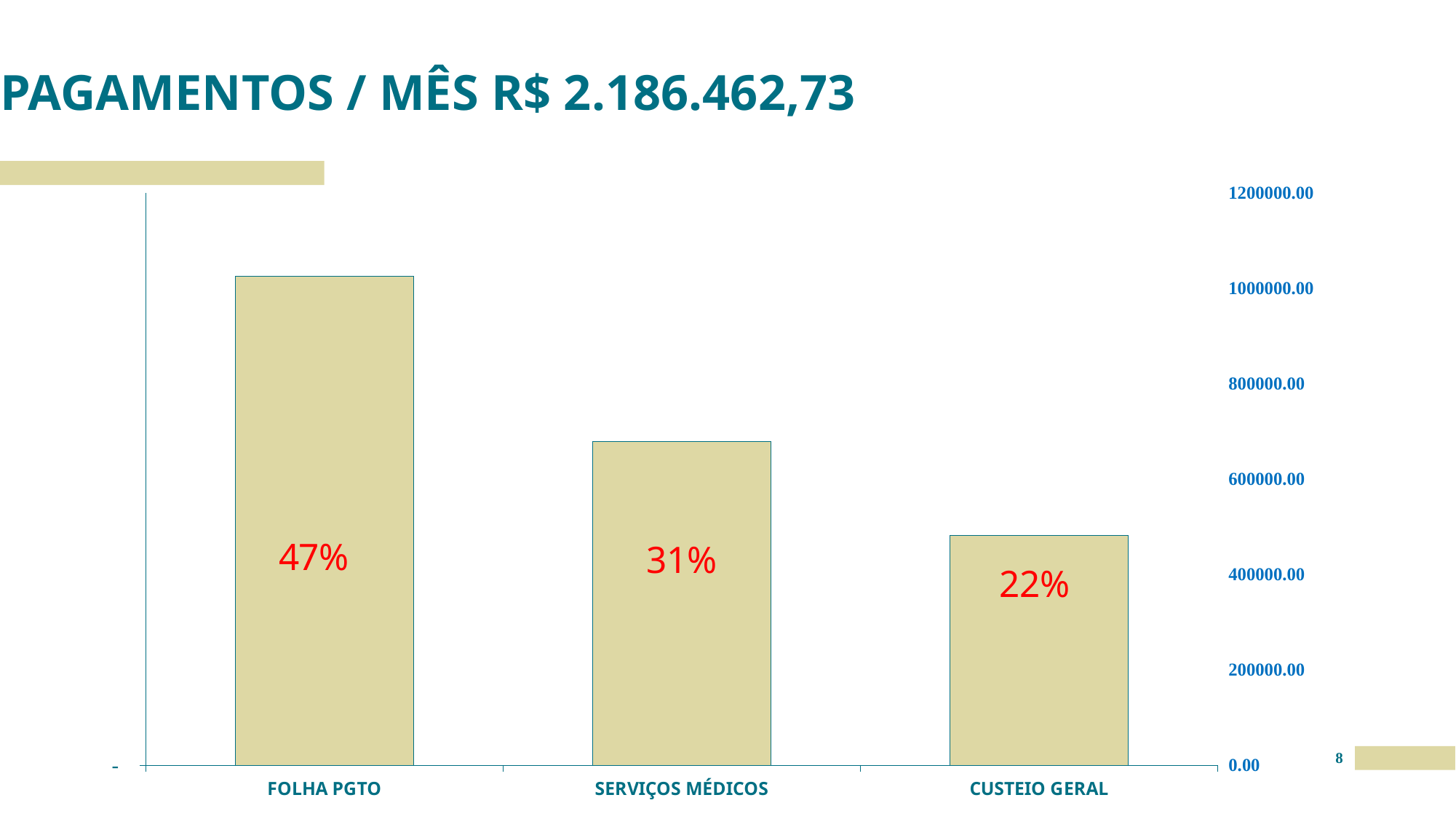
What percentage label is shown on the FOLHA PGTO bar? 47% Which bar is taller, SERVIÇOS MÉDICOS or CUSTEIO GERAL? SERVIÇOS MÉDICOS Which category has the lowest bar? CUSTEIO GERAL What is the title of the slide? PAGAMENTOS / MÊS R$ 2.186.462,73 Which category has the highest bar? FOLHA PGTO What percentage label is shown on the SERVIÇOS MÉDICOS bar? 31% Is the value for FOLHA PGTO greater or less than 1000000.00? greater What kind of chart is shown on the slide? bar chart How many categories are plotted in the chart? 3 What percentage label is shown on the CUSTEIO GERAL bar? 22% What is the difference in percentage points between the FOLHA PGTO label and the CUSTEIO GERAL label? 25 Is the value for CUSTEIO GERAL greater or less than 600000.00? less